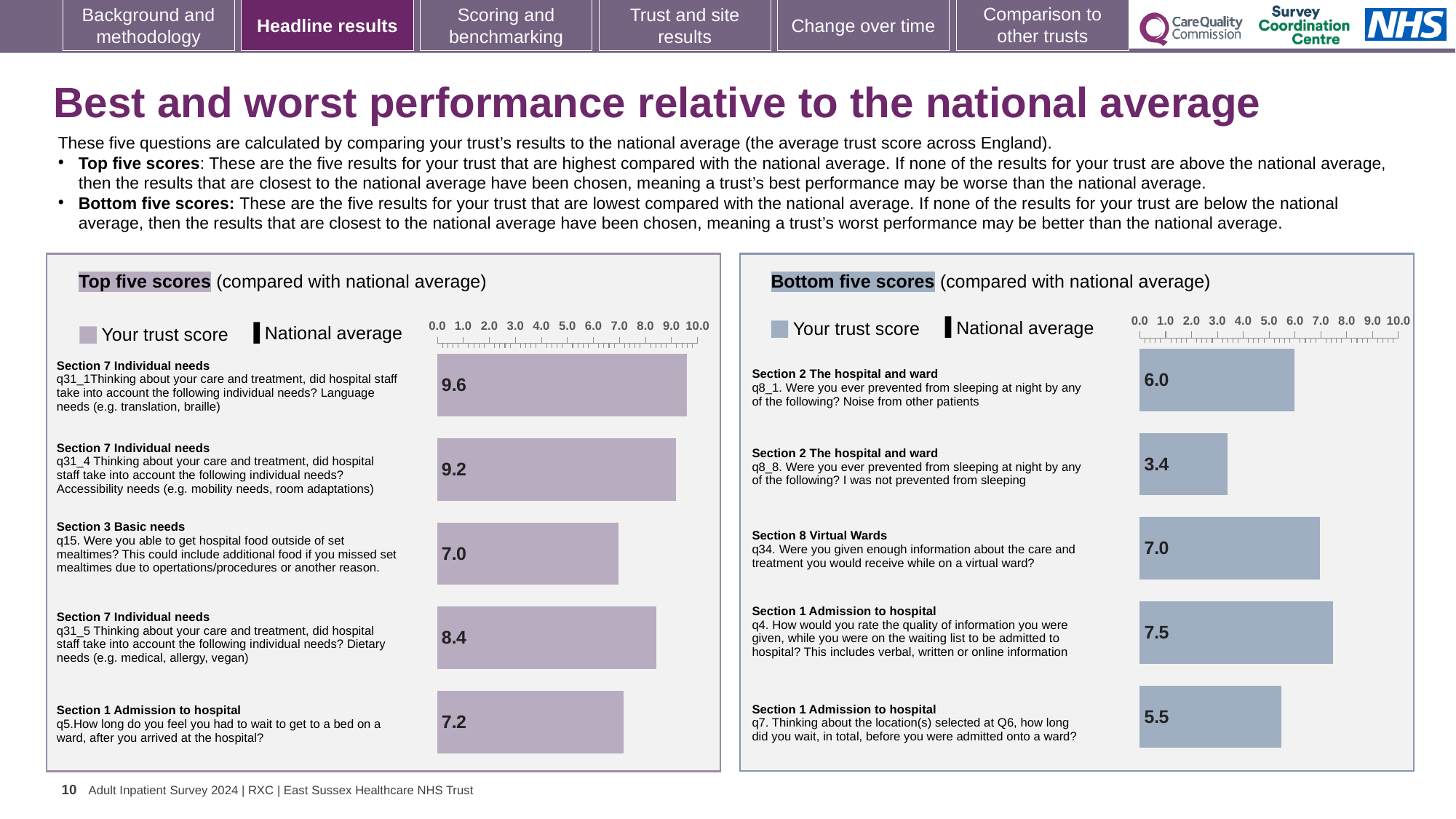
In the Bottom five scores chart, what is the trust score for q4 (quality of information while on the waiting list)? 7.5 In the Top five scores chart, which question has the lowest trust score? q15 (hospital food outside of set mealtimes) In the Top five scores chart, what is the trust score for q15 (hospital food outside of set mealtimes)? 7.0 In the Bottom five scores chart, what is the trust score for q8_8 (I was not prevented from sleeping)? 3.4 What type of chart is used in the Top five scores panel? Bar chart In the Bottom five scores chart, which question has the highest trust score? q4 (quality of information while on the waiting list) How many entries does the legend of the Bottom five scores chart list? 2 In the Bottom five scores chart, which is larger: the score for q8_1 (Noise from other patients) or q7 (wait before admitted onto a ward)? q8_1 (Noise from other patients) In the Top five scores chart, what is the difference between the scores for q31_1 (Language needs) and q5 (wait to get to a bed on a ward)? 2.4 In the Bottom five scores chart, what is the difference between the scores for q34 (virtual ward) and q8_8 (I was not prevented from sleeping)? 3.6 In the Top five scores chart, how many questions are shown? 5 In the Top five scores chart, what is the trust score for q31_1 (Language needs)? 9.6